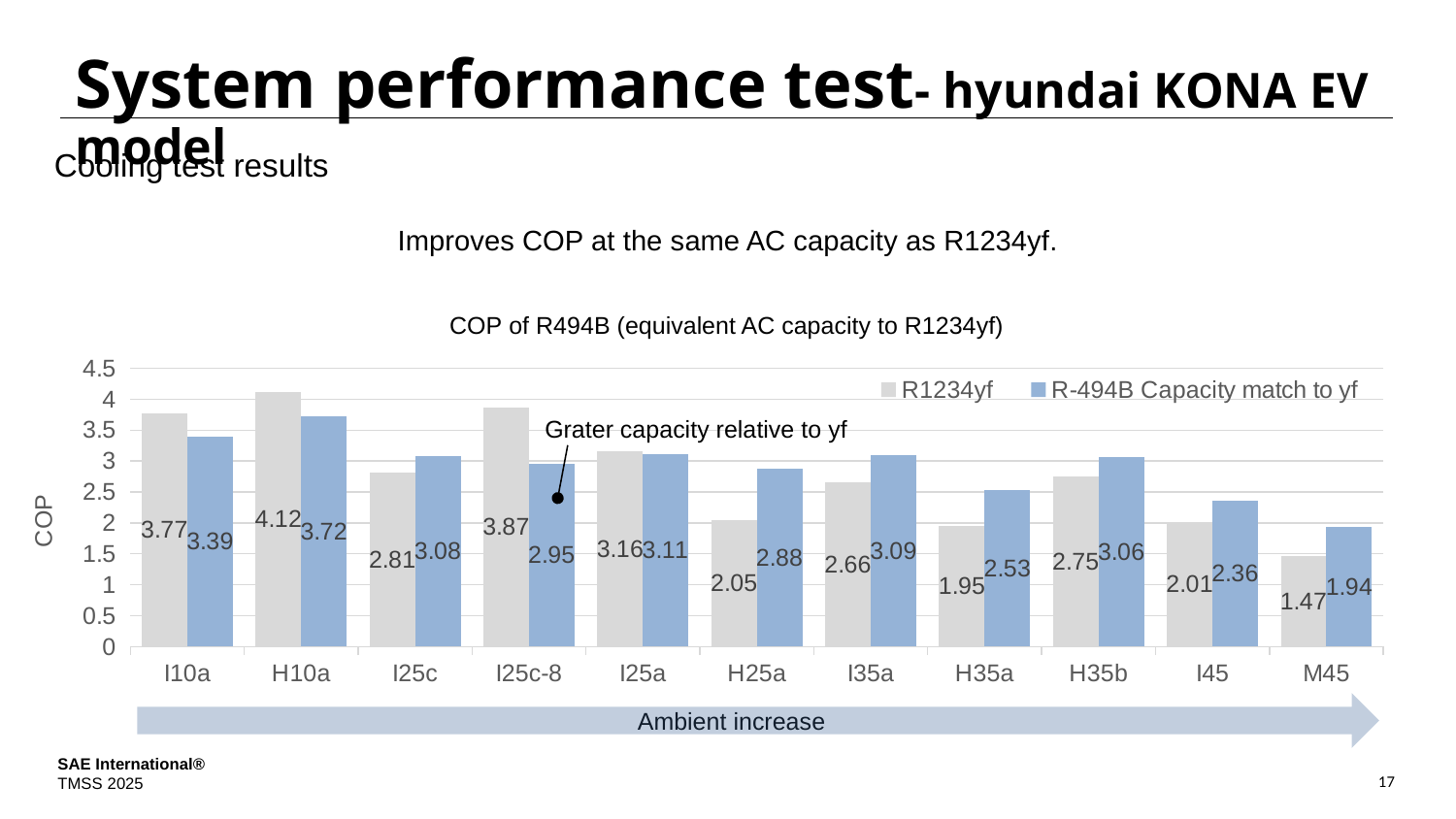
What is the COP of R-494B Capacity match to yf at H25a? 2.88 How many categories are shown on the x axis? 11 What is the title of the chart? COP of R494B (equivalent AC capacity to R1234yf) What kind of chart is shown on the slide? Bar chart Which category has the lowest COP for R-494B Capacity match to yf? M45 What is the difference between the R-494B and R1234yf COP values at H25a? 0.83 What is the COP of R1234yf at M45? 1.47 How many series does the legend list? 2 At I25c, which series has the higher COP, R1234yf or R-494B Capacity match to yf? R-494B Capacity match to yf What is the COP of R1234yf at H10a? 4.12 Is the COP of R1234yf at I25c-8 greater or less than 3.5? greater Which category has the highest COP for R1234yf? H10a